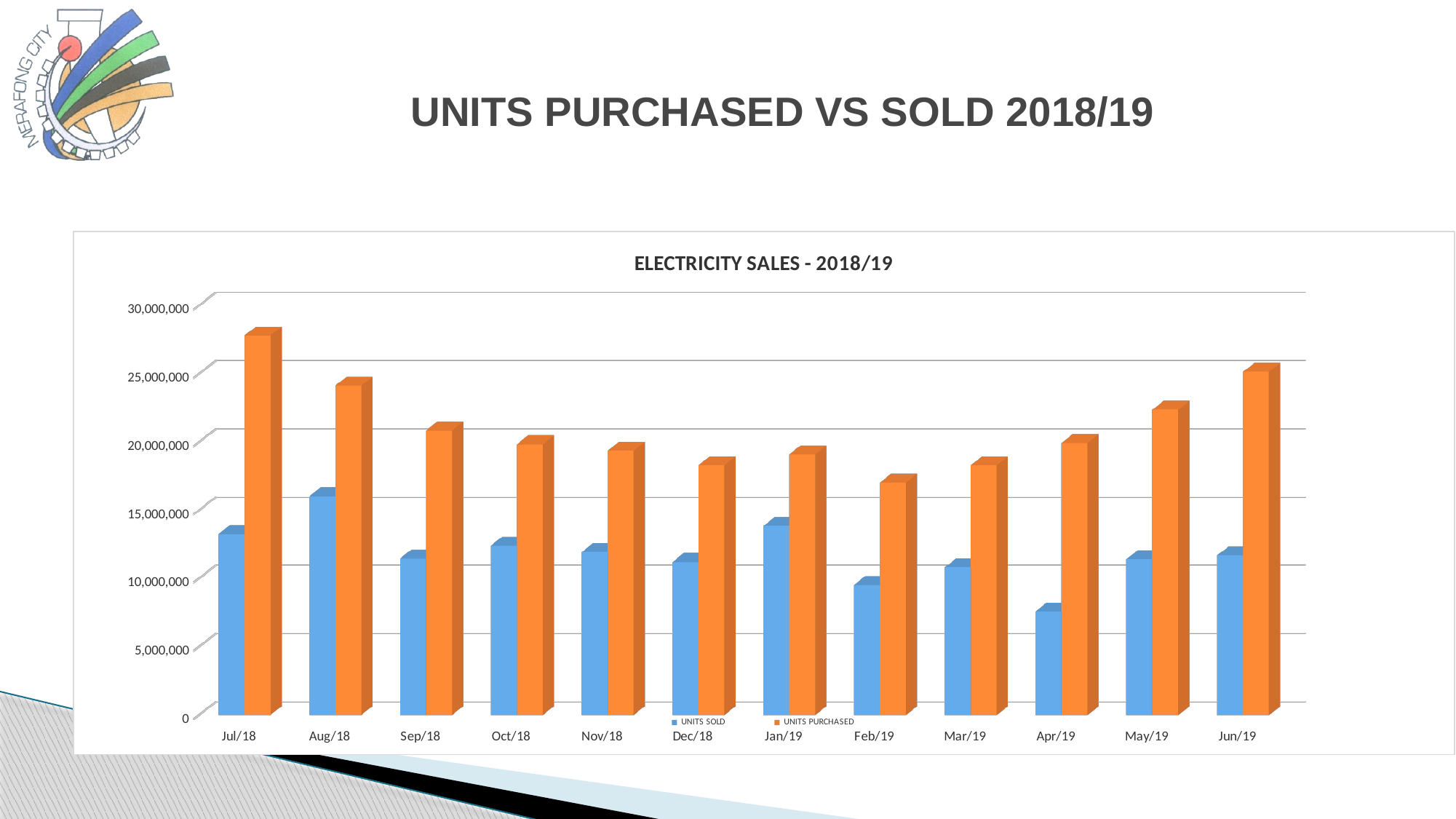
How many series does the legend list? 2 Do UNITS PURCHASED rise or fall from Feb/19 to Jun/19? rise In which month were UNITS PURCHASED lowest? Feb/19 In which month were UNITS SOLD lowest? Apr/19 In which month were UNITS PURCHASED highest? Jul/18 Is the value for UNITS PURCHASED in Jul/18 greater or less than 25,000,000? greater Which is larger: UNITS SOLD in Aug/18 or UNITS SOLD in Jan/19? Aug/18 Is the value for UNITS PURCHASED in Feb/19 greater or less than 20,000,000? less In which month were UNITS SOLD highest? Aug/18 How many months are shown on the x axis? 12 Is the value for UNITS SOLD in Apr/19 greater or less than 10,000,000? less What type of chart is shown on the slide? Bar chart